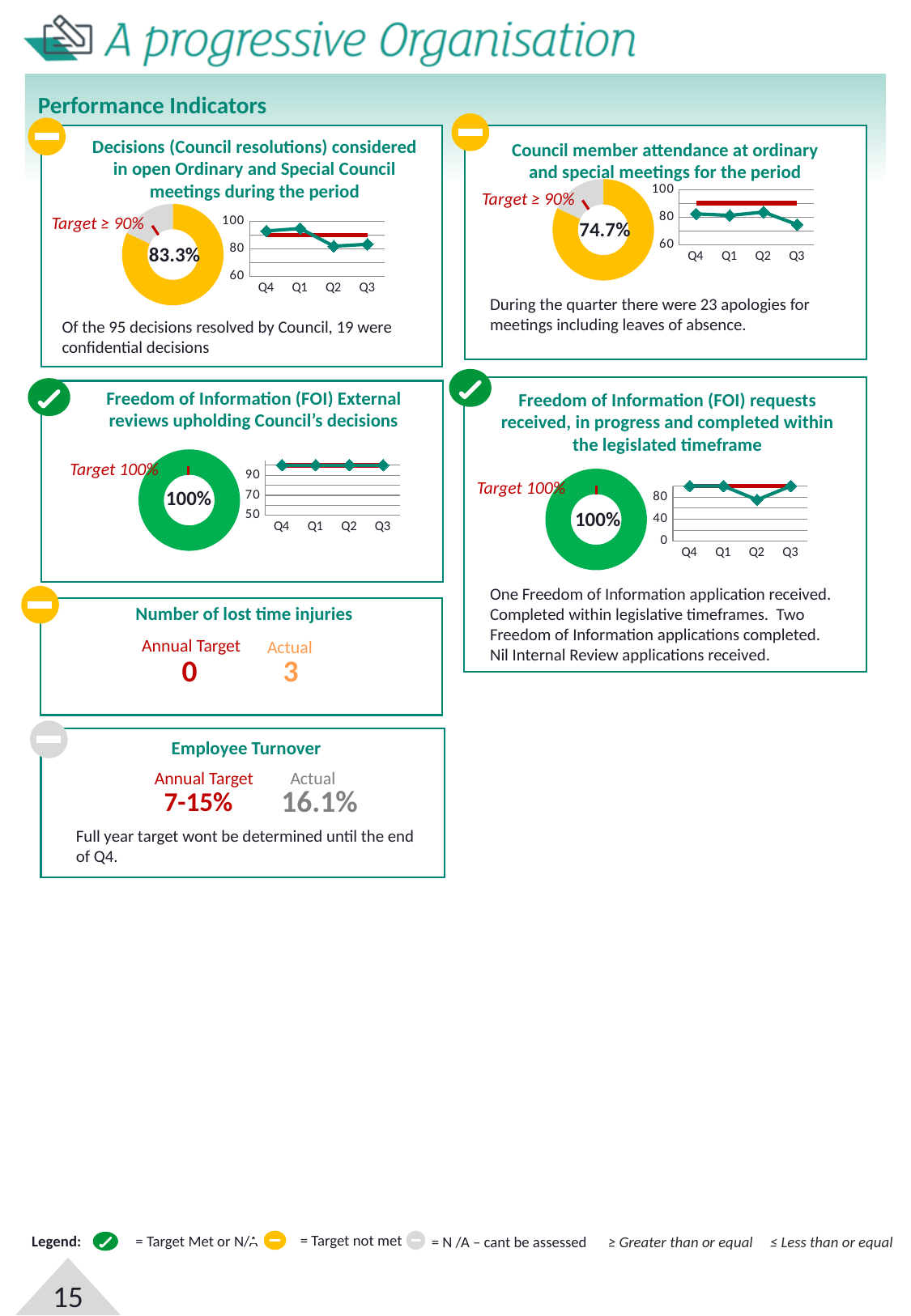
On the line chart in the 'Council member attendance at ordinary and special meetings for the period' panel, which is larger, the value for Q2 or the value for Q3? Q2 On the 'Freedom of Information (FOI) requests received, in progress and completed within the legislated timeframe' chart, what percentage is shown in the centre of the donut? 100% On the 'Council member attendance at ordinary and special meetings for the period' chart, what percentage is shown in the centre of the donut? 74.7% On the 'Decisions (Council resolutions) considered in open Ordinary and Special Council meetings during the period' chart, what is the target stated next to the donut? Target ≥ 90% On the line chart in the 'Decisions (Council resolutions) considered in open Ordinary and Special Council meetings during the period' panel, which quarter has the lowest value? Q2 On the line chart in the 'Council member attendance at ordinary and special meetings for the period' panel, is the value for Q3 greater or less than 80? less On the 'Freedom of Information (FOI) External reviews upholding Council's decisions' chart, what percentage is shown in the centre of the donut? 100% On the 'Decisions (Council resolutions) considered in open Ordinary and Special Council meetings during the period' chart, what percentage is shown in the centre of the donut? 83.3% On the line chart in the 'Freedom of Information (FOI) requests received, in progress and completed within the legislated timeframe' panel, which quarter has the lowest value? Q2 How many quarters are plotted on the x axis of the line chart in the 'Council member attendance at ordinary and special meetings for the period' panel? 4 On the line chart in the 'Decisions (Council resolutions) considered in open Ordinary and Special Council meetings during the period' panel, is the value for Q1 greater or less than 80? greater What kind of chart shows the quarterly values (Q4, Q1, Q2, Q3) in the 'Decisions (Council resolutions) considered in open Ordinary and Special Council meetings during the period' panel? Line chart